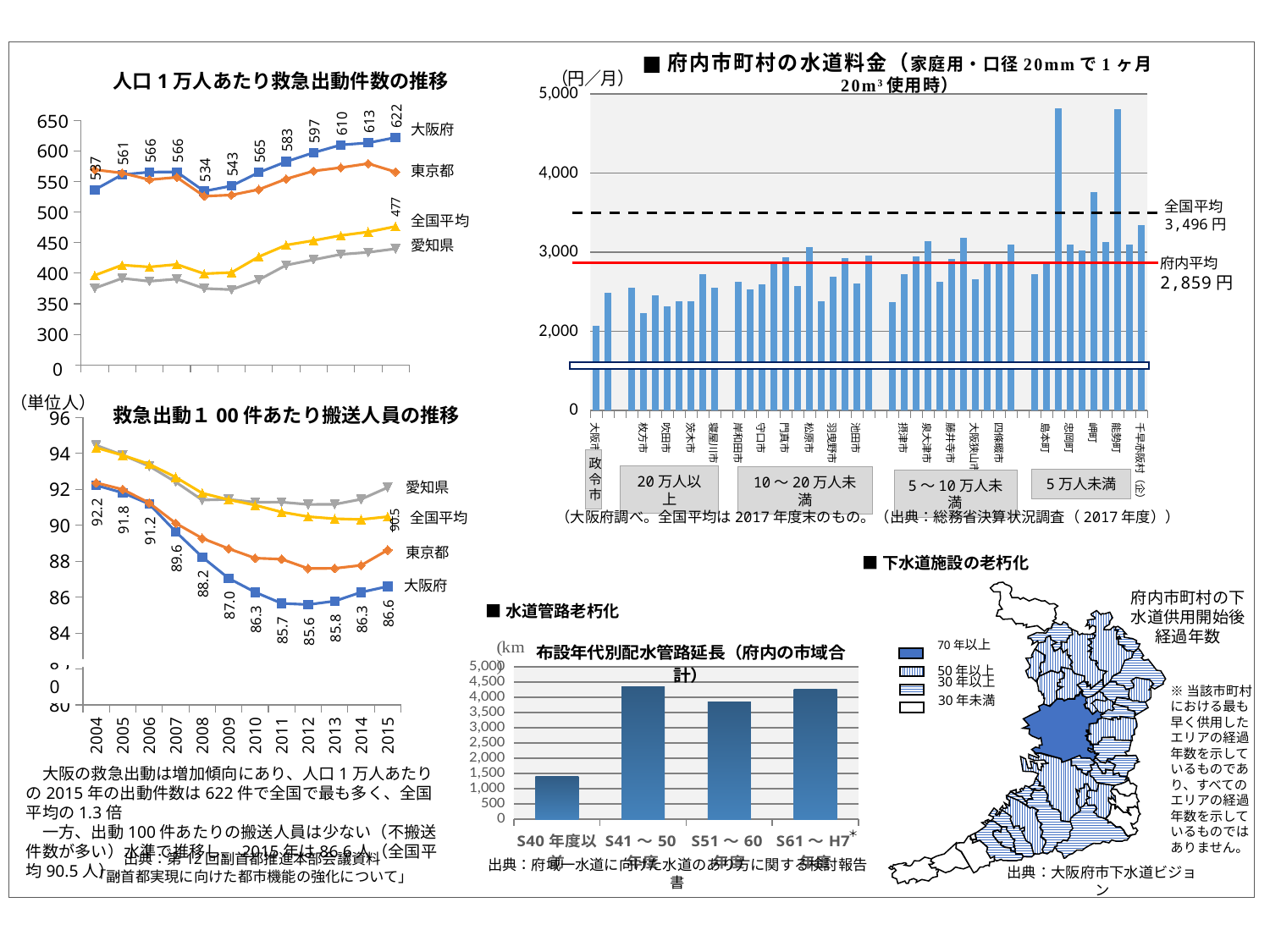
In the chart titled 人口1万人あたり救急出動件数の推移, which series has the highest value in 2015? 大阪府 In the chart titled 救急出動100件あたり搬送人員の推移, what is the value for 大阪府 in 2015? 86.6 In the chart titled 府内市町村の水道料金, what is the 全国平均 value shown? 3,496円 In the chart titled 人口1万人あたり救急出動件数の推移, what is the value for 大阪府 in 2015? 622 In the chart titled 府内市町村の水道料金, what is the difference between the 全国平均 and the 府内平均? 637円 How many categories are shown in the chart titled 布設年代別配水管路延長（府内の市域合計）? 4 In the chart titled 救急出動100件あたり搬送人員の推移, in which year is the 大阪府 value lowest? 2012 In the chart titled 布設年代別配水管路延長（府内の市域合計）, is the value for S40年度以前 greater or less than 1,500? less In the chart titled 人口1万人あたり救急出動件数の推移, what is the value for 大阪府 in 2004? 537 In the chart titled 人口1万人あたり救急出動件数の推移, by how much did the 大阪府 value increase from 2004 to 2015? 85 How many series are plotted in the chart titled 人口1万人あたり救急出動件数の推移? 4 In the chart titled 救急出動100件あたり搬送人員の推移, what is the difference between the 大阪府 values in 2004 and 2015? 5.6